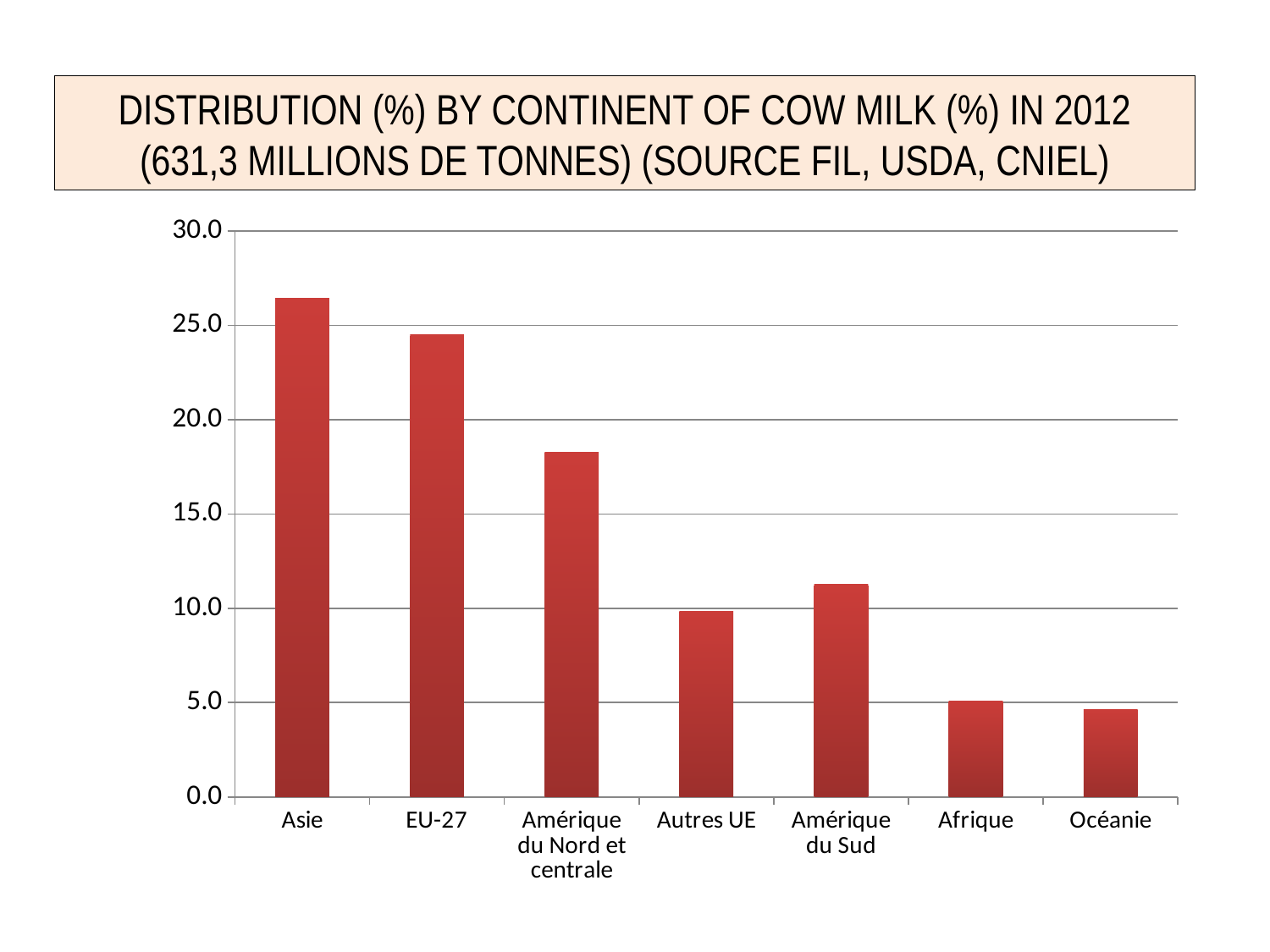
Which is larger, the value for EU-27 or the value for Amérique du Nord et centrale? EU-27 Which is larger, the value for Amérique du Sud or the value for Autres UE? Amérique du Sud Is the value for Océanie greater or less than 5.0? less What kind of chart is shown on the slide? bar chart How many continents/regions are shown on the x axis? 7 Which region has the lowest share of cow milk production? Océanie Is the value for Amérique du Sud greater or less than 10.0? greater Is the value for Amérique du Nord et centrale greater or less than 15.0? greater What is the maximum value shown on the y axis? 30.0 Which region has the highest share of cow milk production? Asie